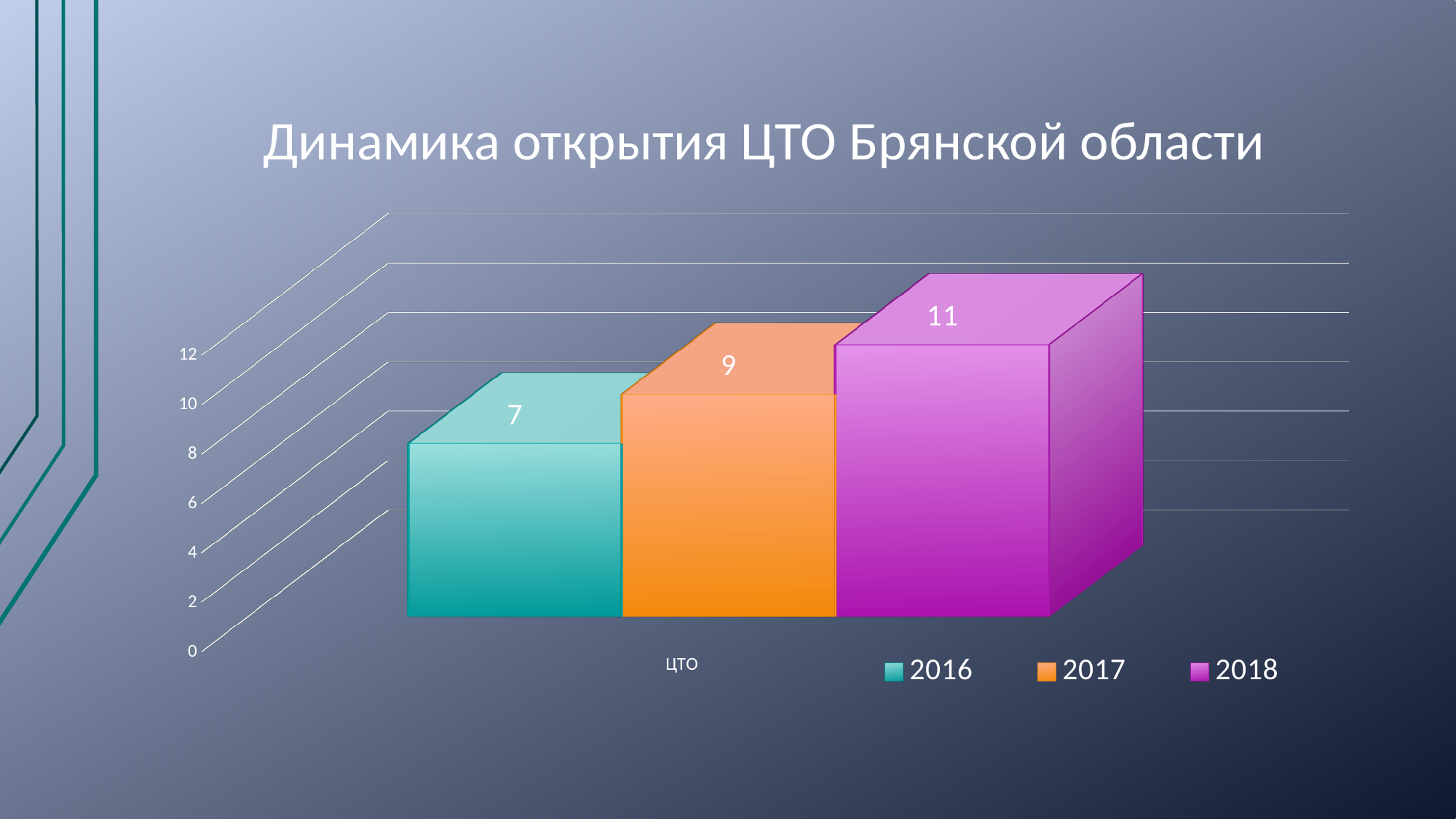
What is the title of the chart? Динамика открытия ЦТО Брянской области What is the difference between the values for 2018 and 2016? 4 Do the values rise or fall from 2016 to 2018? rise What is the value for 2018? 11 What is the difference between the values for 2017 and 2016? 2 What is the value for 2016? 7 What kind of chart is shown on the slide? bar chart What is the value for 2017? 9 Which year has the lowest value? 2016 How many series does the legend list? 3 Which is larger, the value for 2017 or the value for 2018? 2018 Which year has the highest value? 2018